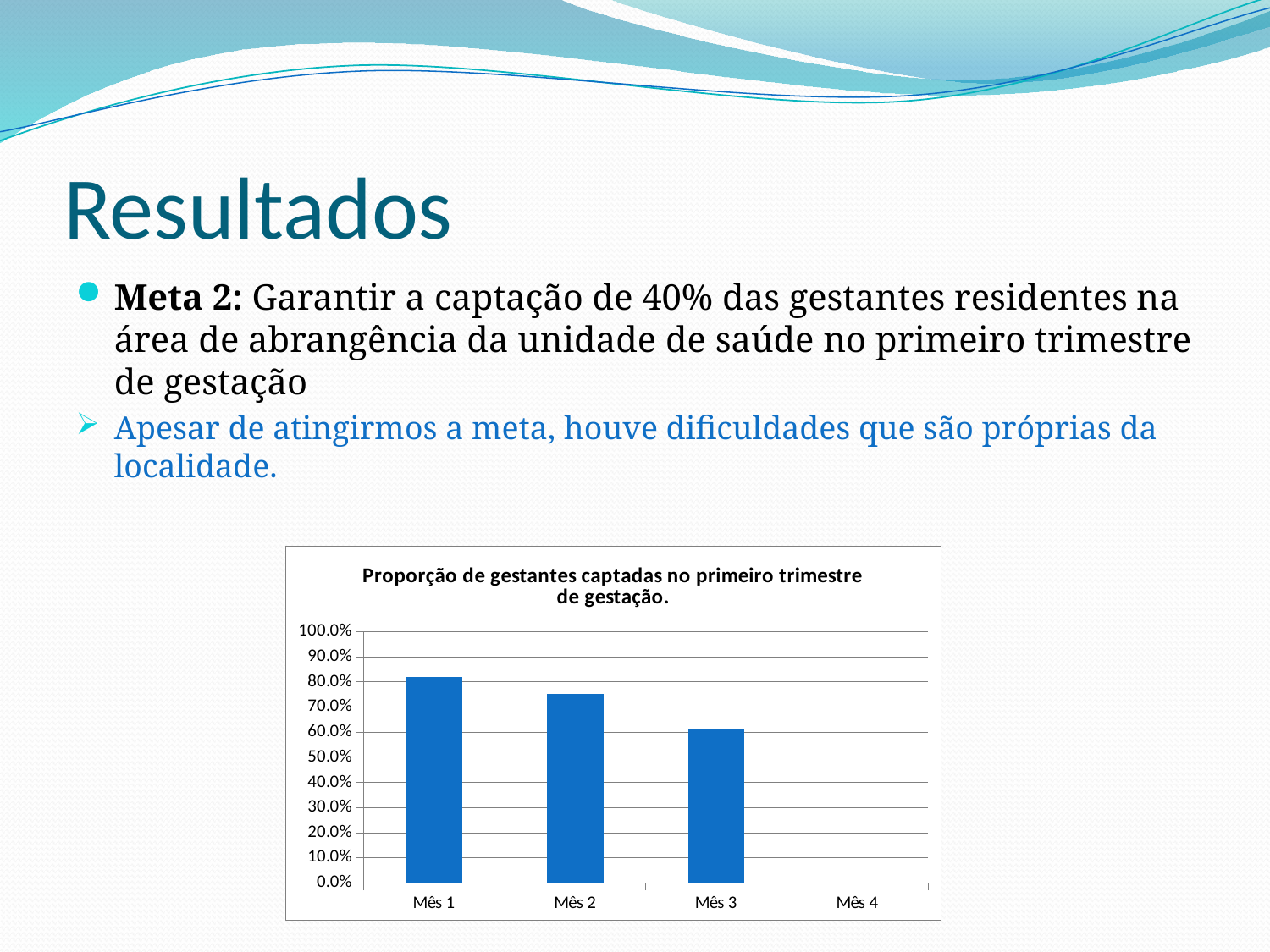
How many categories are shown on the x axis of the chart? 4 Which is larger, the value for Mês 2 or the value for Mês 3? Mês 2 Is the value for Mês 1 greater or less than 70.0%? greater Which month has the highest value in the chart? Mês 1 Is the value for Mês 2 greater or less than 80.0%? less What is the title of the chart? Proporção de gestantes captadas no primeiro trimestre de gestação. Is the value for Mês 2 greater or less than 70.0%? greater Which month has no visible bar in the chart? Mês 4 Which is larger, the value for Mês 1 or the value for Mês 3? Mês 1 Do the values rise or fall from Mês 1 to Mês 3? fall What kind of chart is shown on the slide? bar chart